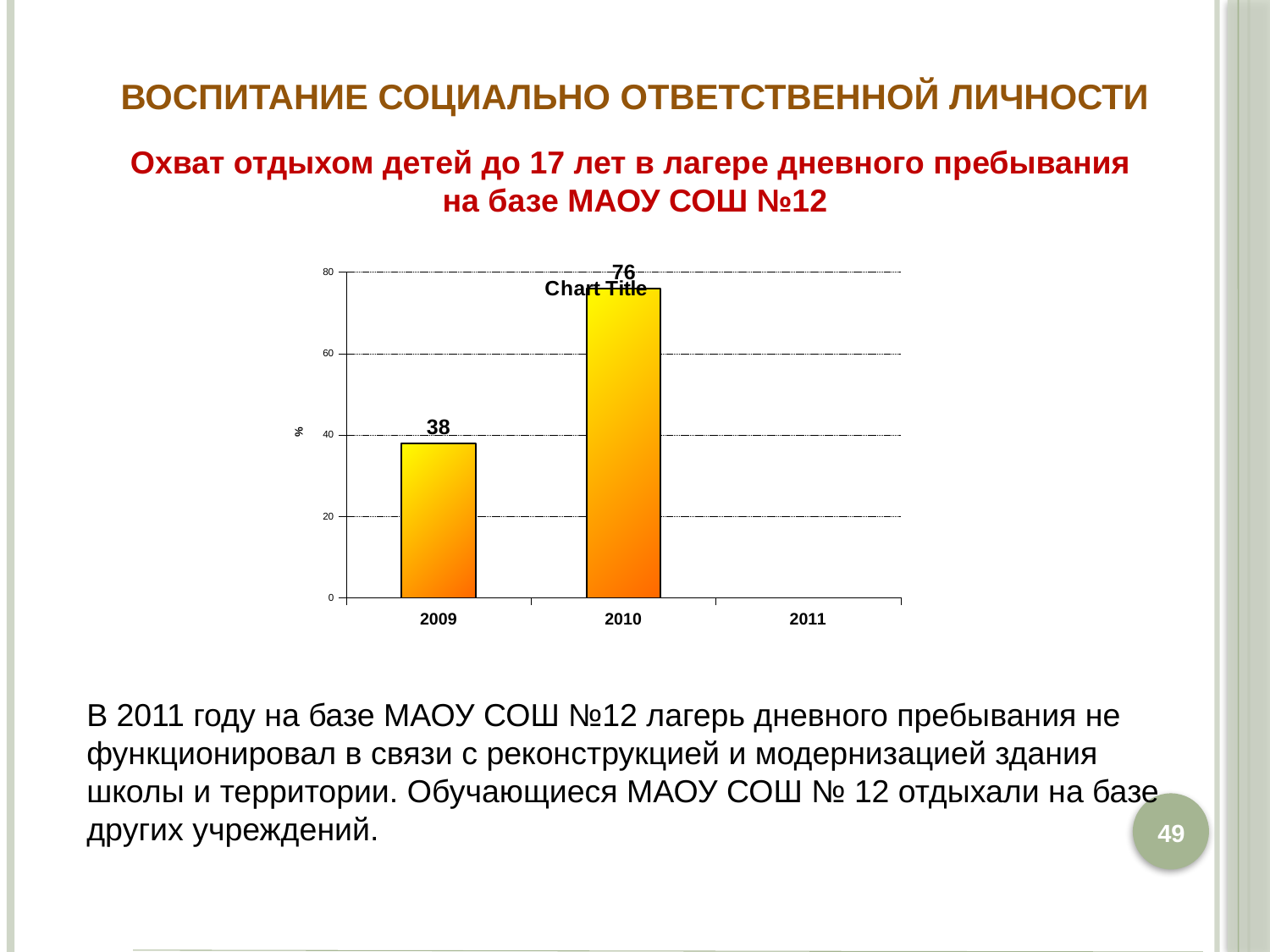
What is the difference between the values for 2010 and 2009? 38 What kind of chart is shown? bar chart Which is larger, the value for 2009 or the value for 2010? 2010 What is the label on the vertical axis? % How many years are labelled on the x axis? 3 Which year on the x axis has no bar plotted? 2011 Is the value for 2009 greater or less than 40? less What is the value for 2010? 76 What is the value for 2009? 38 Which year has the highest value? 2010 Does the value rise or fall from 2009 to 2010? rise Is the value for 2010 greater or less than 60? greater